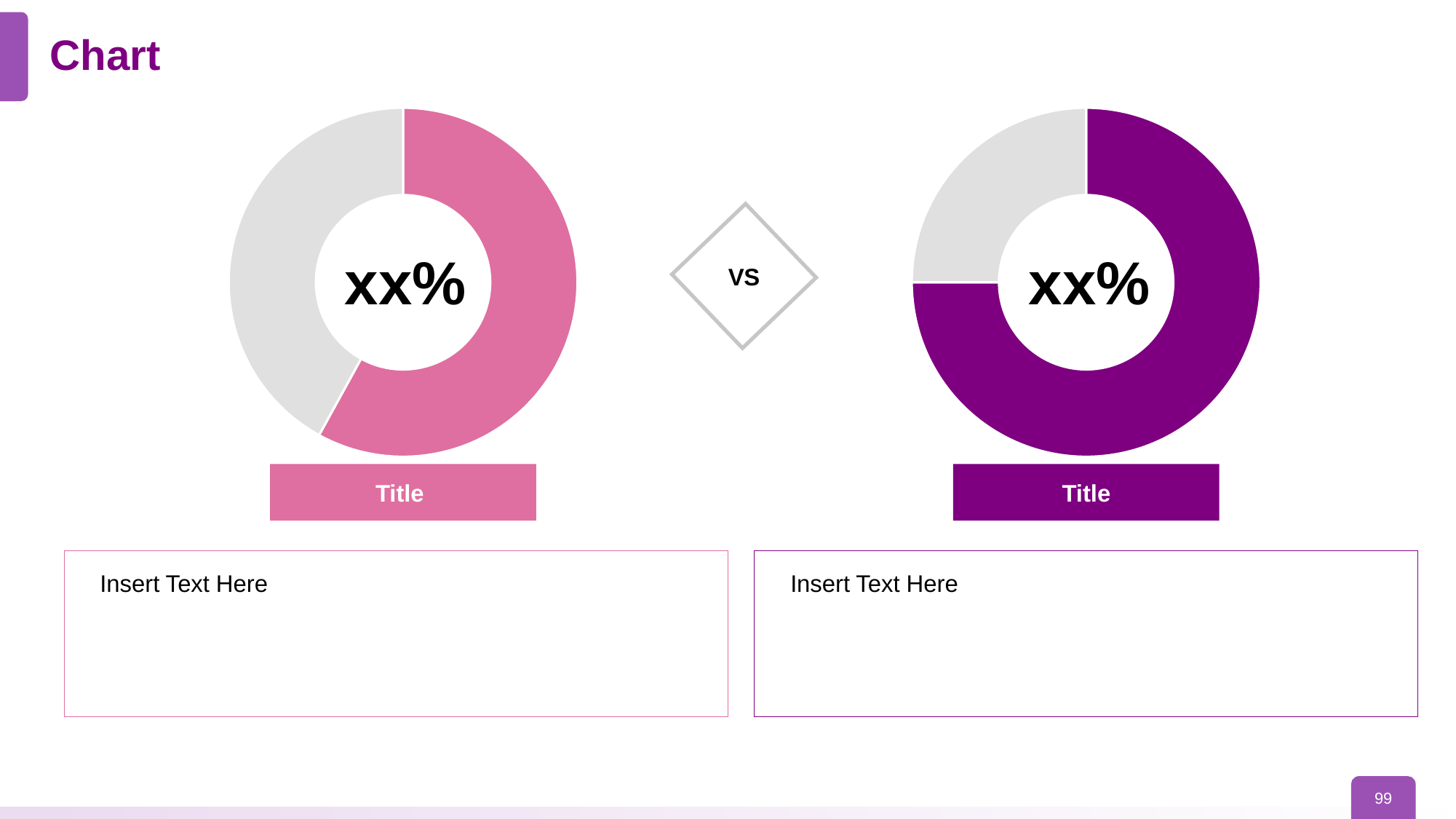
What text is shown in the label box below the right chart? Title How many slices does the right chart have? 2 What kind of chart is the left chart on the slide? doughnut chart Which chart has the larger coloured (non-grey) slice, the left chart or the right chart? the right chart In the left chart, which slice is larger, the pink slice or the grey slice? the pink slice How many slices does the left chart have? 2 What kind of chart is the right chart on the slide? doughnut chart What colour is the highlighted slice in the left chart? pink In the right chart, which slice is larger, the purple slice or the grey slice? the purple slice